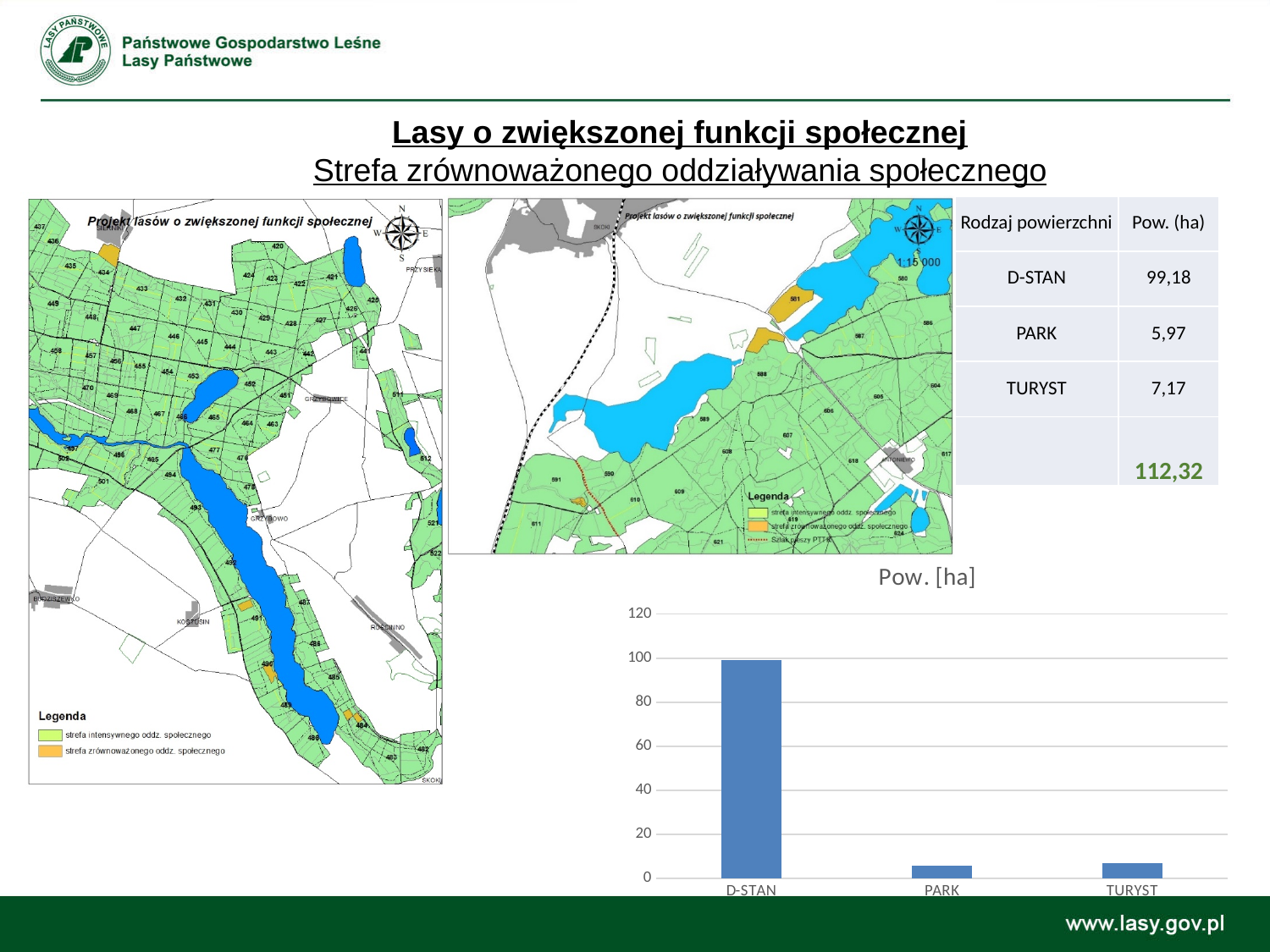
How many categories are shown on the x axis of the chart? 3 Is the value for PARK greater or less than 20? less What is the title of the chart on the slide? Pow. [ha] Which category has the highest value in the chart? D-STAN Which is larger, the value for D-STAN or the value for TURYST? D-STAN Is the value for D-STAN greater or less than 80? greater Is the value for TURYST greater or less than 40? less According to the table on the slide, what is the area (Pow. (ha)) for PARK? 5,97 Which category has the lowest value in the chart? PARK What is the highest value shown on the y axis of the chart? 120 According to the table on the slide, what is the area (Pow. (ha)) for D-STAN? 99,18 What kind of chart is shown on the slide? bar chart